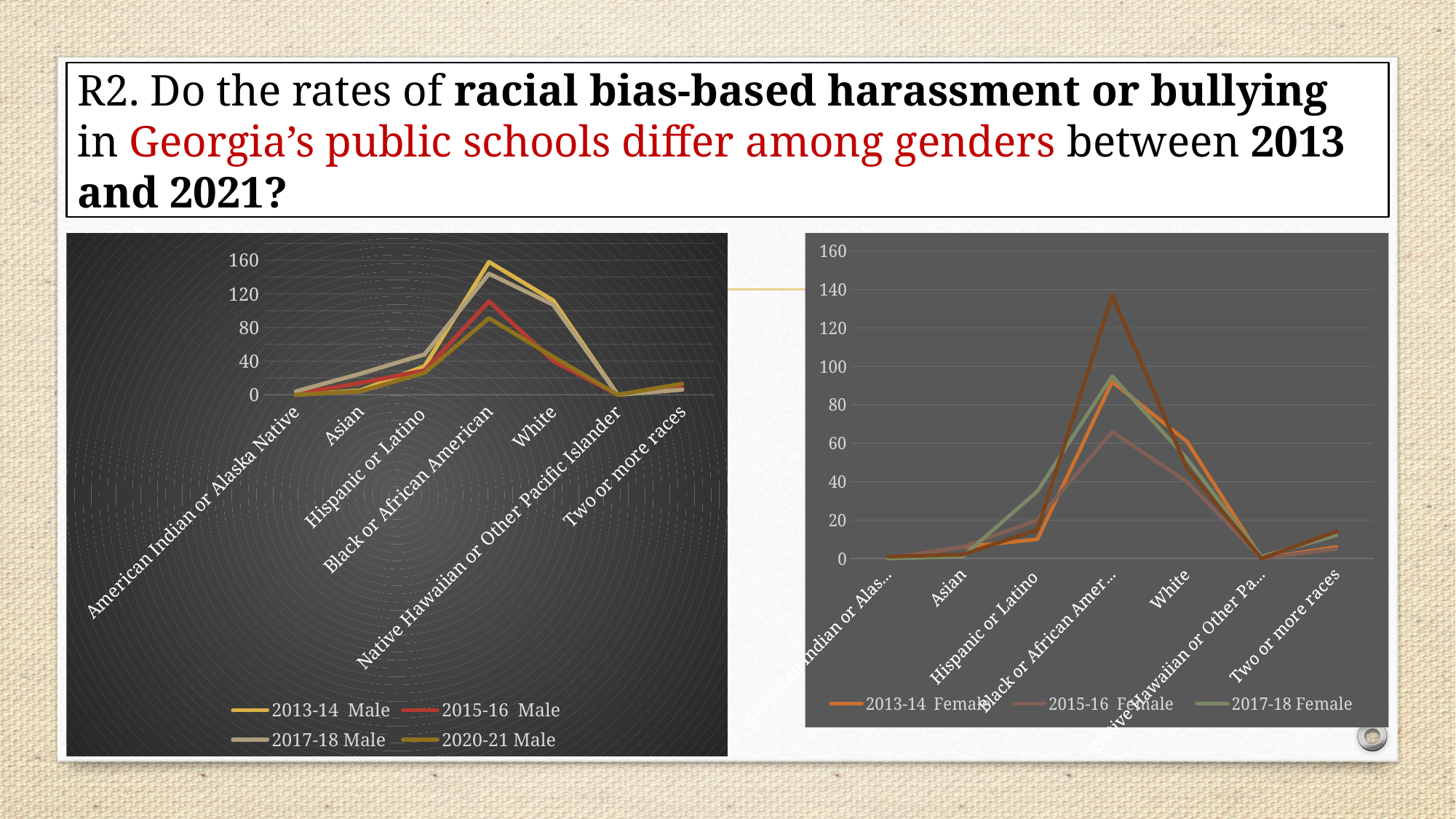
In the left chart (Male), which is larger for the 2013-14 Male series: Black or African American or White? Black or African American In the left chart (Male), is the value for Native Hawaiian or Other Pacific Islander in the 2013-14 Male series greater or less than 40? less How many series does the legend of the left chart (Male) list? 4 How many categories are shown on the x axis of the left chart (Male)? 7 In the left chart (Male), is the value for Black or African American in the 2013-14 Male series greater or less than 140? greater In the right chart (Female), is the value for Black or African American in the 2013-14 Female series greater or less than 80? greater How many series does the legend of the right chart (Female) list? 3 What kind of chart is the left chart (Male)? line chart In the left chart (Male), which category has the highest value for the 2013-14 Male series? Black or African American In the right chart (Female), which is larger for Hispanic or Latino: the 2013-14 Female series or the 2017-18 Female series? 2017-18 Female